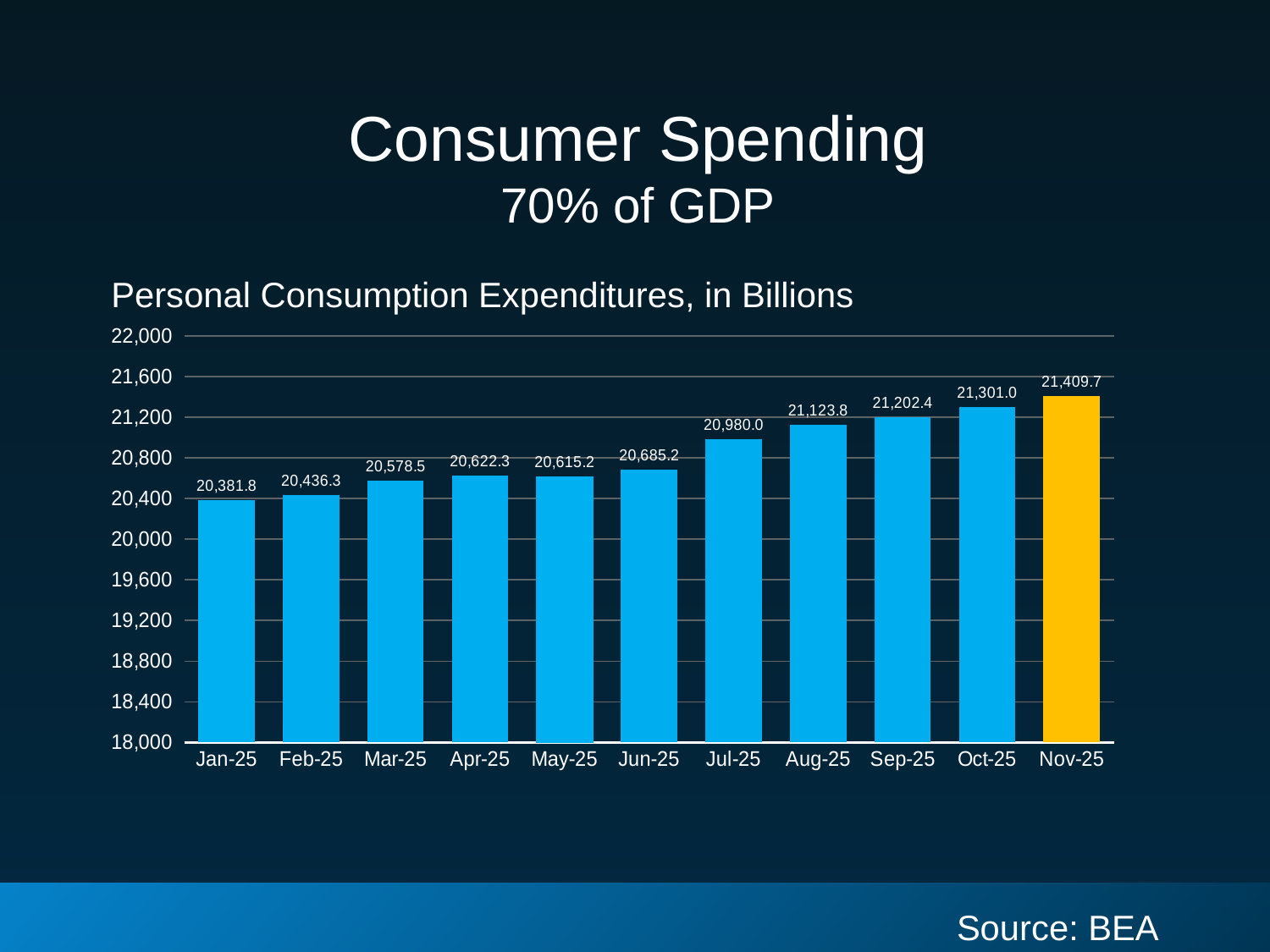
What is the difference between the values for Jul-25 and Jun-25? 294.8 Which is larger, the value for Mar-25 or the value for Aug-25? Aug-25 Do the values generally rise or fall from Jan-25 to Nov-25? rise How many months are shown on the x axis? 11 Is the value for Sep-25 greater or less than 21,200? greater What is the value for Jan-25? 20,381.8 What kind of chart is shown on the slide? bar chart What is the value for Jul-25? 20,980.0 What is the difference between the values for Nov-25 and Oct-25? 108.7 Which month has the lowest value? Jan-25 Which month has the highest value? Nov-25 What is the value for Nov-25? 21,409.7